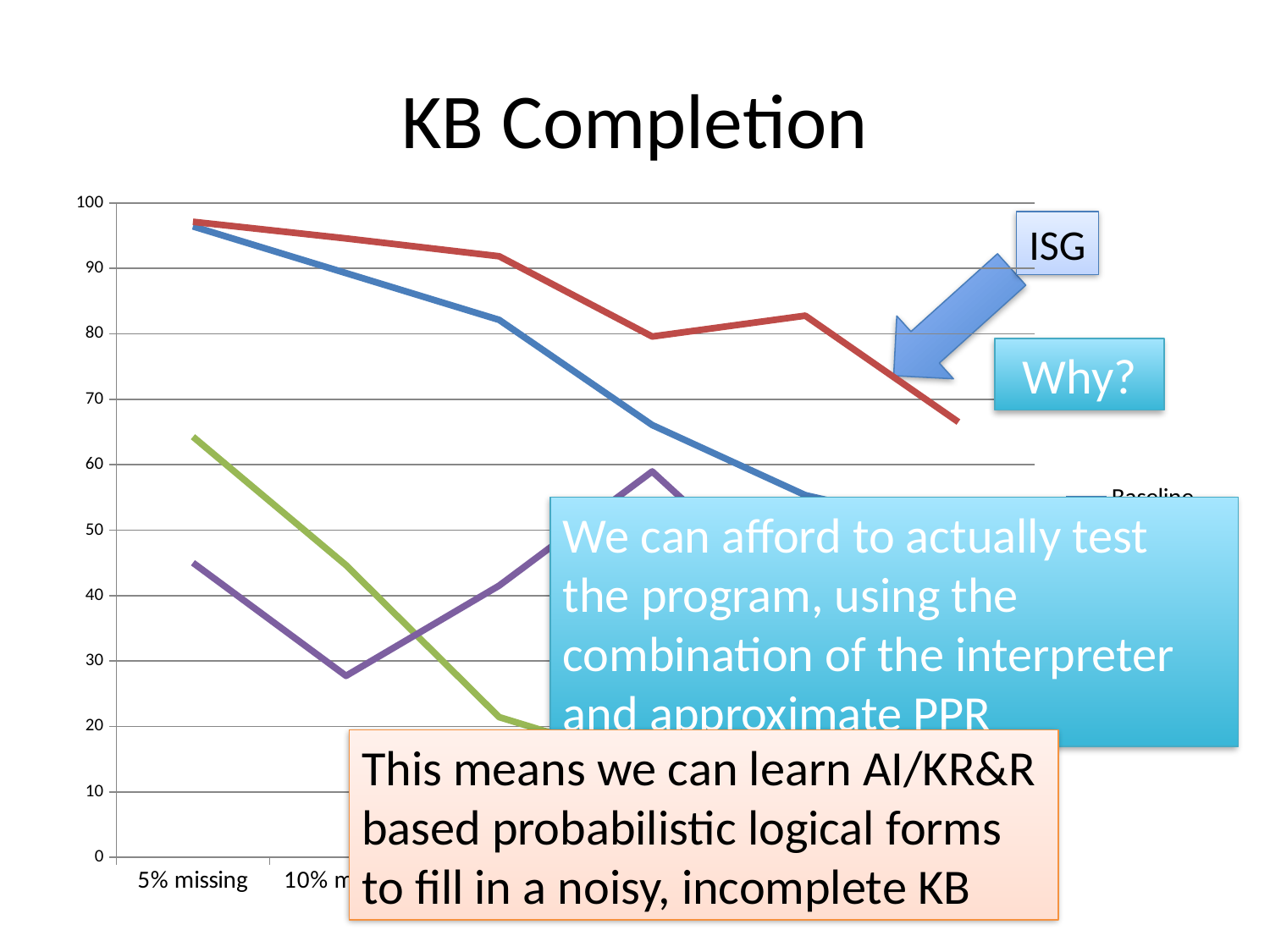
Which line has the lowest value at 5% missing? the purple line Is the value of the green line at 5% missing greater or less than 60? greater Is the value of the blue line at 5% missing greater or less than 90? greater Is the value of the purple line at 5% missing greater or less than 50? less What is the title of the chart? KB Completion At 5% missing, which is larger: the green line or the purple line? the green line Does the blue line rise or fall from left to right along the x axis? fall How many lines are plotted on the chart? 4 Does the red line generally rise or fall from left to right along the x axis? fall Which line does the 'ISG' label with the arrow point to? the red line What kind of chart is shown on the slide? line chart